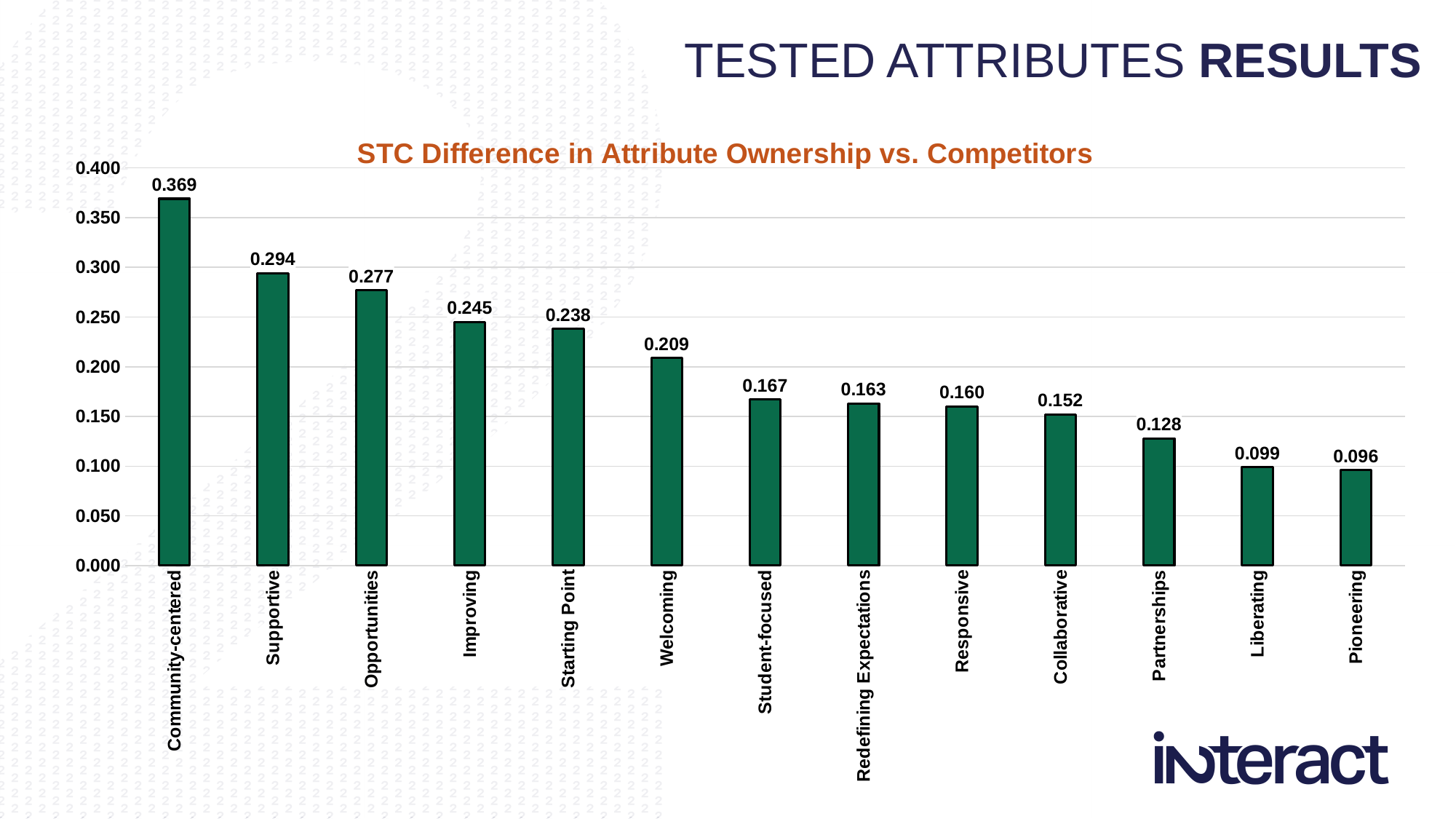
What is the value for Welcoming? 0.209 What is the difference between the values for Community-centered and Pioneering? 0.273 What is the value for Community-centered? 0.369 How many attributes are shown in the chart? 13 What kind of chart is shown on the slide? bar chart Which is larger, the value for Improving or the value for Student-focused? Improving What is the title of the chart? STC Difference in Attribute Ownership vs. Competitors What is the value for Partnerships? 0.128 Which attribute has the lowest value? Pioneering Which attribute has the highest value? Community-centered What is the difference between the values for Supportive and Opportunities? 0.017 Is the value for Starting Point greater or less than 0.200? greater